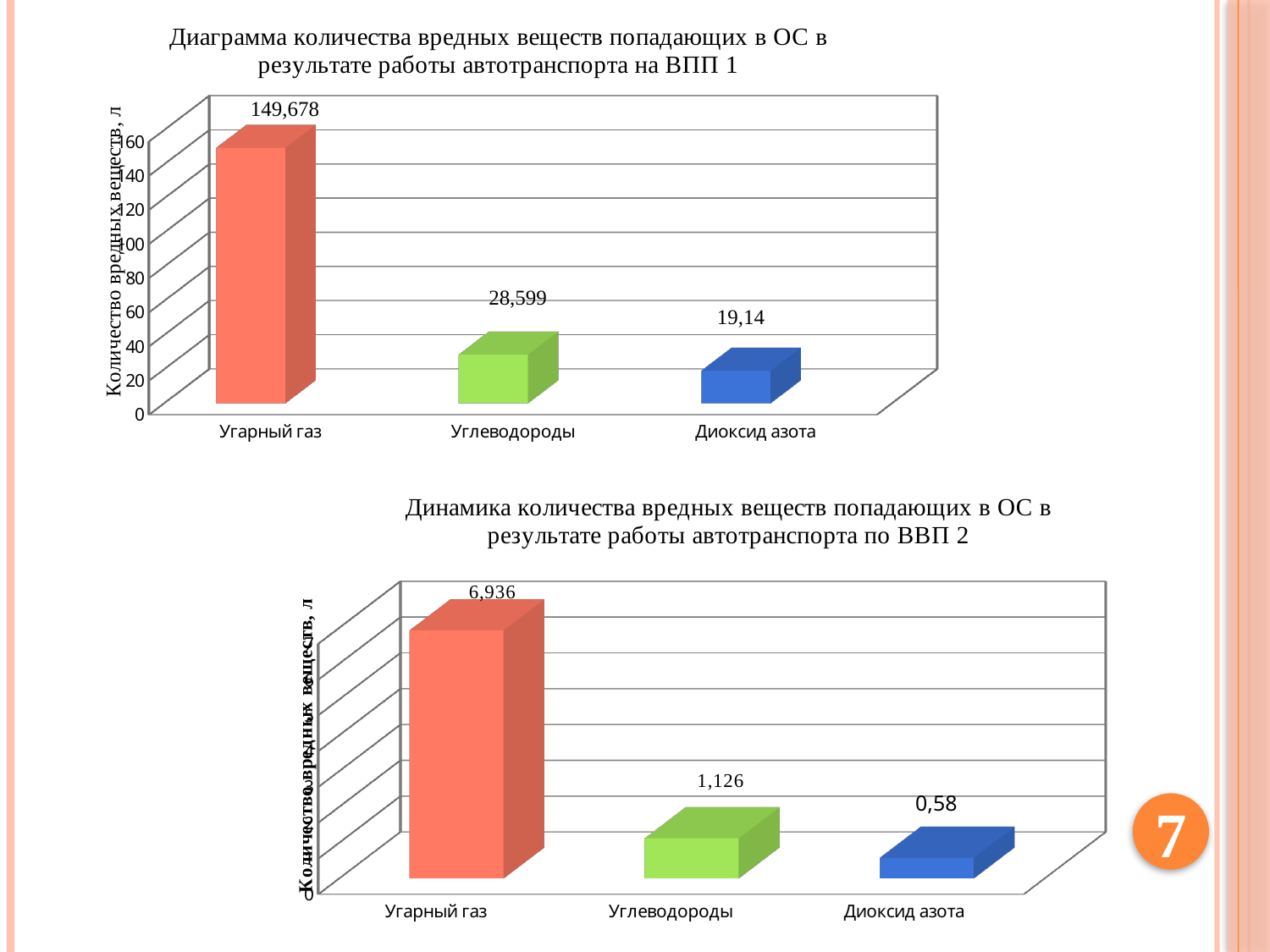
In the top chart (ВПП 1), what is the value for Диоксид азота? 19,14 How many categories are shown in the bottom chart (ВВП 2)? 3 In the top chart (ВПП 1), which category has the highest value? Угарный газ In the bottom chart (ВВП 2), what is the value for Диоксид азота? 0,58 In the top chart (ВПП 1), what is the difference between the values for Угарный газ and Углеводороды? 121,079 In the bottom chart (ВВП 2), what is the difference between the values for Углеводороды and Диоксид азота? 0,546 In the bottom chart (ВВП 2), what is the value for Угарный газ? 6,936 In the top chart (ВПП 1), which category has the lowest value? Диоксид азота What kind of chart is the top chart (ВПП 1)? Bar chart In the bottom chart (ВВП 2), which is larger, the value for Углеводороды or the value for Диоксид азота? Углеводороды In the top chart (ВПП 1), what is the value for Углеводороды? 28,599 In the top chart (ВПП 1), what is the value for Угарный газ? 149,678